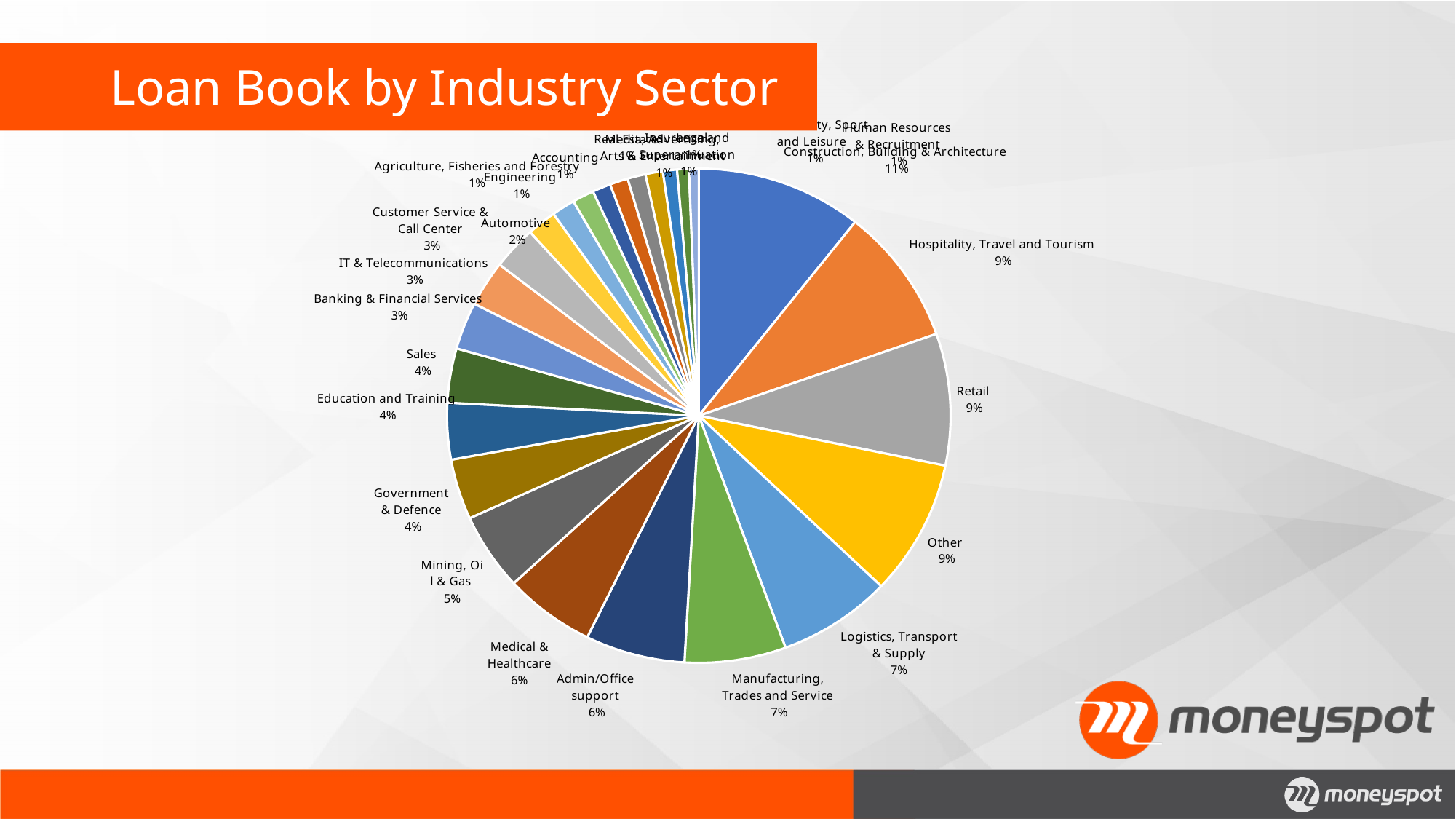
What is the title of the chart? Loan Book by Industry Sector What share of the loan book is Banking & Financial Services? 3% Which industry sector has the largest share of the loan book? Construction, Building & Architecture What share of the loan book is Mining, Oil & Gas? 5% What kind of chart is shown on the slide? pie chart What share of the loan book is Medical & Healthcare? 6% Which has the larger share: Hospitality, Travel and Tourism or Logistics, Transport & Supply? Hospitality, Travel and Tourism How many percentage points larger is the Construction, Building & Architecture share than the Retail share? 2%